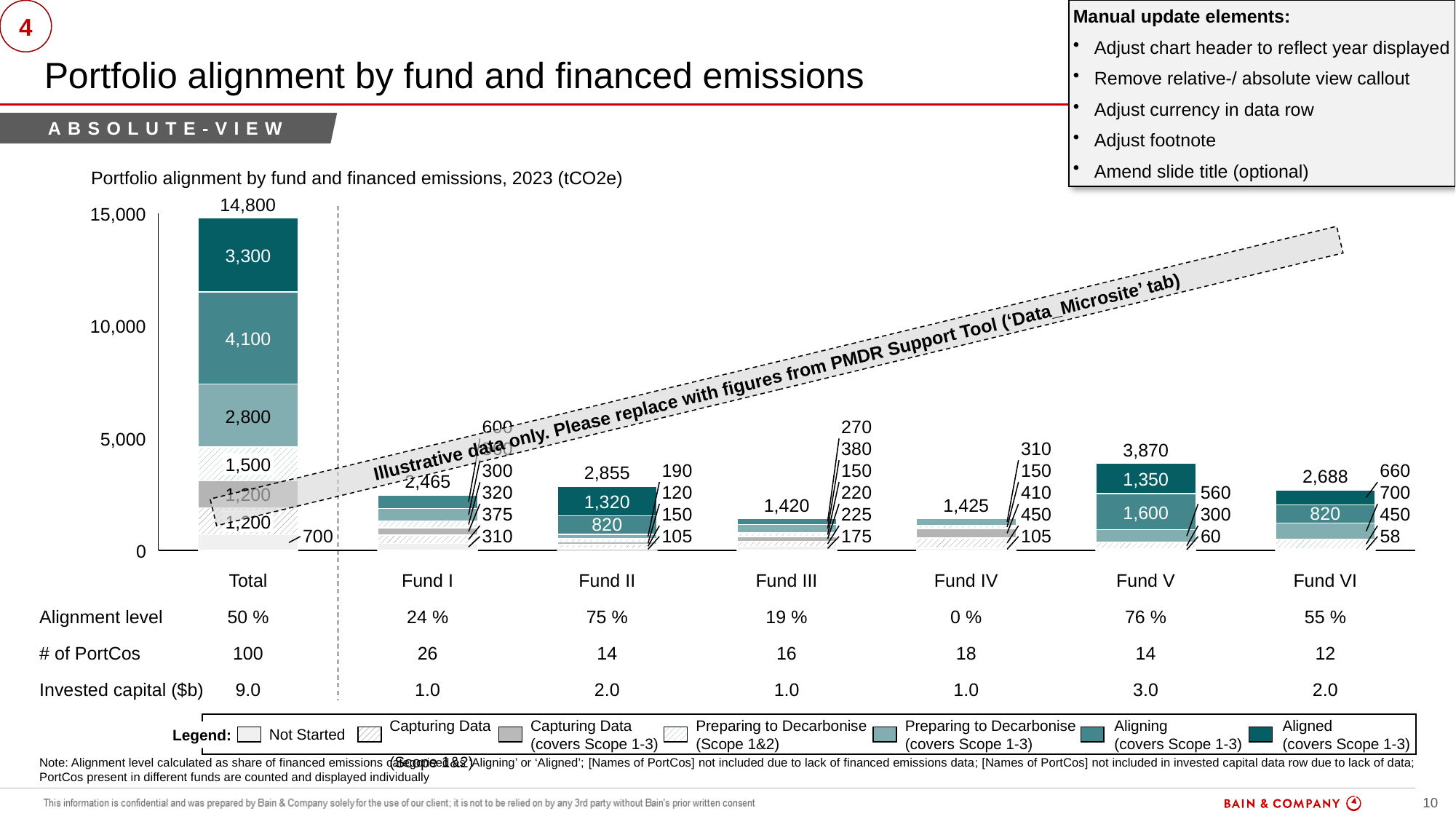
Which has a larger total financed emissions value, Fund I or Fund VI? Fund VI What is the value of the Aligning (covers Scope 1-3) segment in the Total bar? 4,100 How many bars (categories) are plotted on the x axis? 7 What kind of chart is shown on the slide? Stacked bar chart How many entries does the legend list? 7 Is the value of the Total bar greater or less than 10,000? greater What is the value of the Aligned (covers Scope 1-3) segment in the Total bar? 3,300 What is the difference between the total for Fund V and the total for Fund II? 1,015 Which individual fund has the lowest total financed emissions? Fund III What is the total financed emissions value shown above the Fund V bar? 3,870 What is the alignment level shown for Fund V in the data row below the chart? 76 % Which individual fund has the highest total financed emissions? Fund V